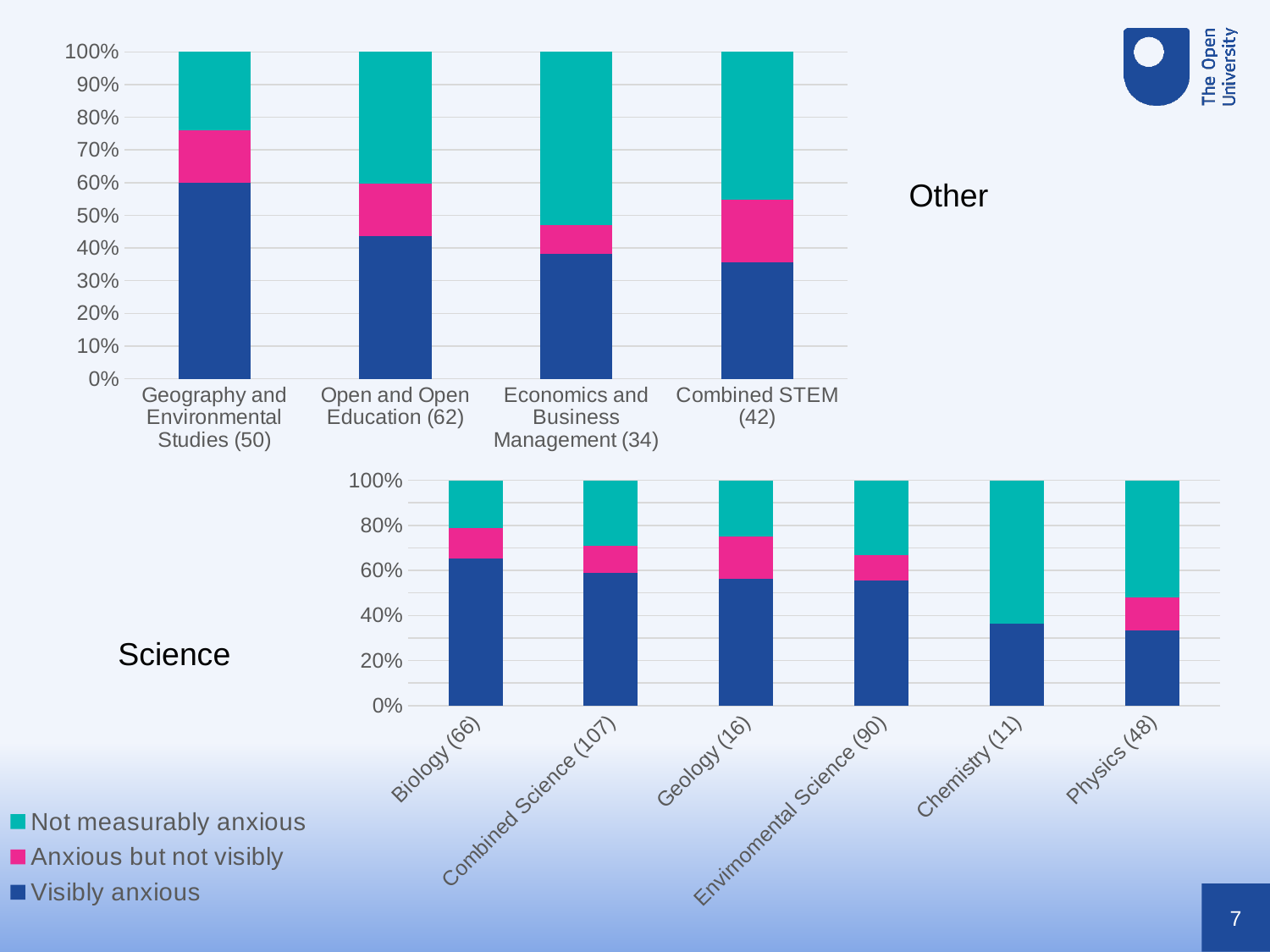
How many series does the legend list? 3 In the top chart labelled "Other", how many categories are shown on the x axis? 4 In the bottom chart labelled "Science", which category has the largest "Visibly anxious" share? Biology (66) In the bottom chart labelled "Science", how many categories are shown on the x axis? 6 In the bottom chart labelled "Science", is the "Visibly anxious" share for Physics (48) greater or less than 40%? less In the top chart labelled "Other", which has the larger "Visibly anxious" share: Geography and Environmental Studies (50) or Combined STEM (42)? Geography and Environmental Studies (50) In the top chart labelled "Other", is the "Visibly anxious" share for Combined STEM (42) greater or less than 40%? less In the bottom chart labelled "Science", which category has the largest "Not measurably anxious" share? Chemistry (11) What kind of chart is the top chart labelled "Other"? Stacked bar chart In the top chart labelled "Other", is the "Visibly anxious" share for Open and Open Education (62) greater or less than 40%? greater In the bottom chart labelled "Science", which category shows no "Anxious but not visibly" segment? Chemistry (11) In the top chart labelled "Other", which category has the largest "Visibly anxious" share? Geography and Environmental Studies (50)